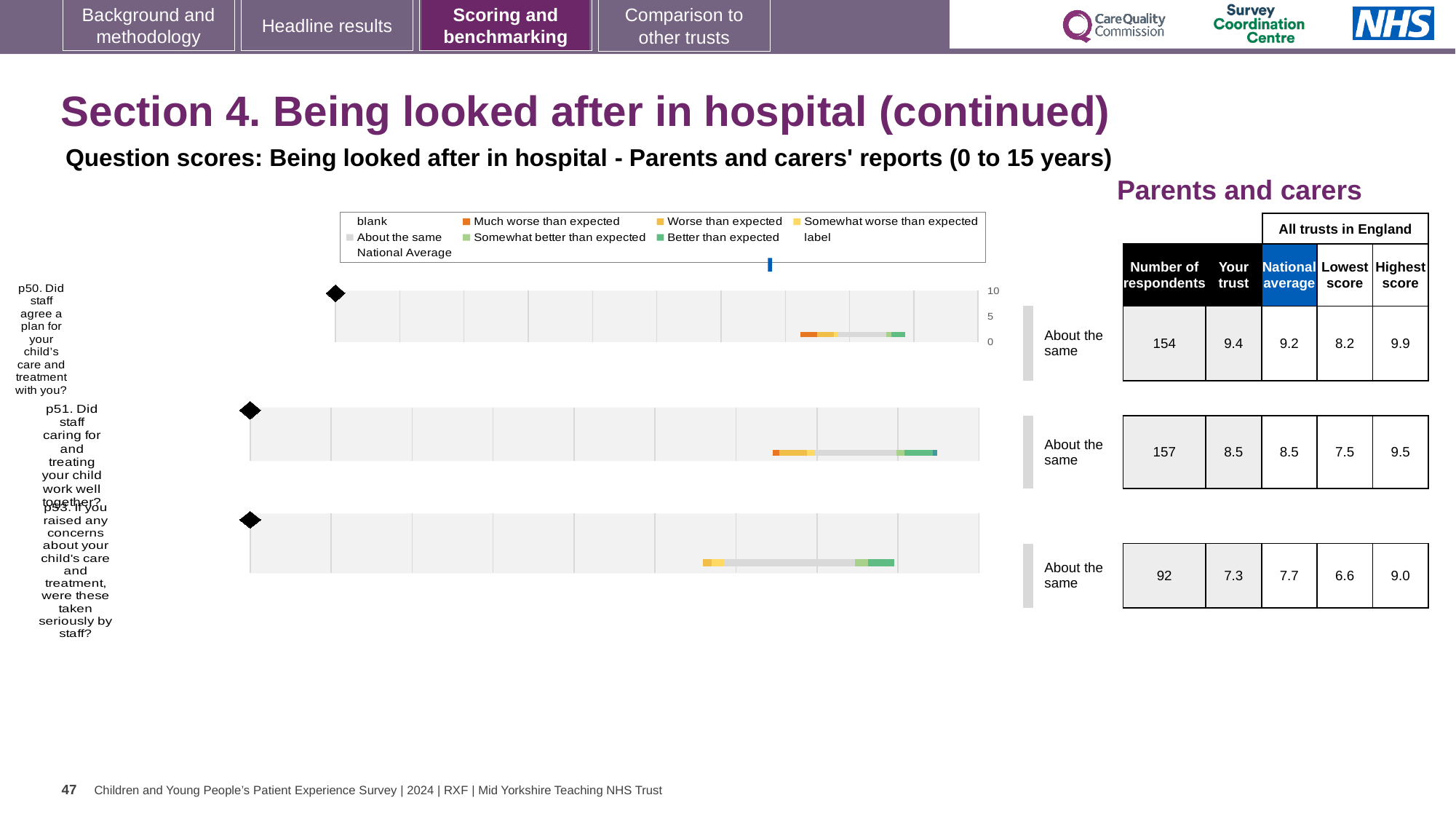
How many questions are charted on this slide? 3 Which question has the lowest 'Your trust' score on this slide? p53 What benchmark category is shown for p51? About the same For p53, which is larger: the 'Your trust' score or the national average? National average Which question has the highest 'Your trust' score on this slide? p50 What is the difference between the highest and lowest scores for p51? 2.0 How many respondents are shown for p53 (If you raised any concerns about your child's care and treatment, were these taken seriously by staff?)? 92 What is the 'Your trust' score for p50 (Did staff agree a plan for your child's care and treatment with you?)? 9.4 What is the national average score for p51 (Did staff caring for and treating your child work well together?)? 8.5 For p50, how much higher is the 'Your trust' score than the national average? 0.2 What is the lowest score among all trusts in England for p53? 6.6 What is the highest score among all trusts in England for p50? 9.9